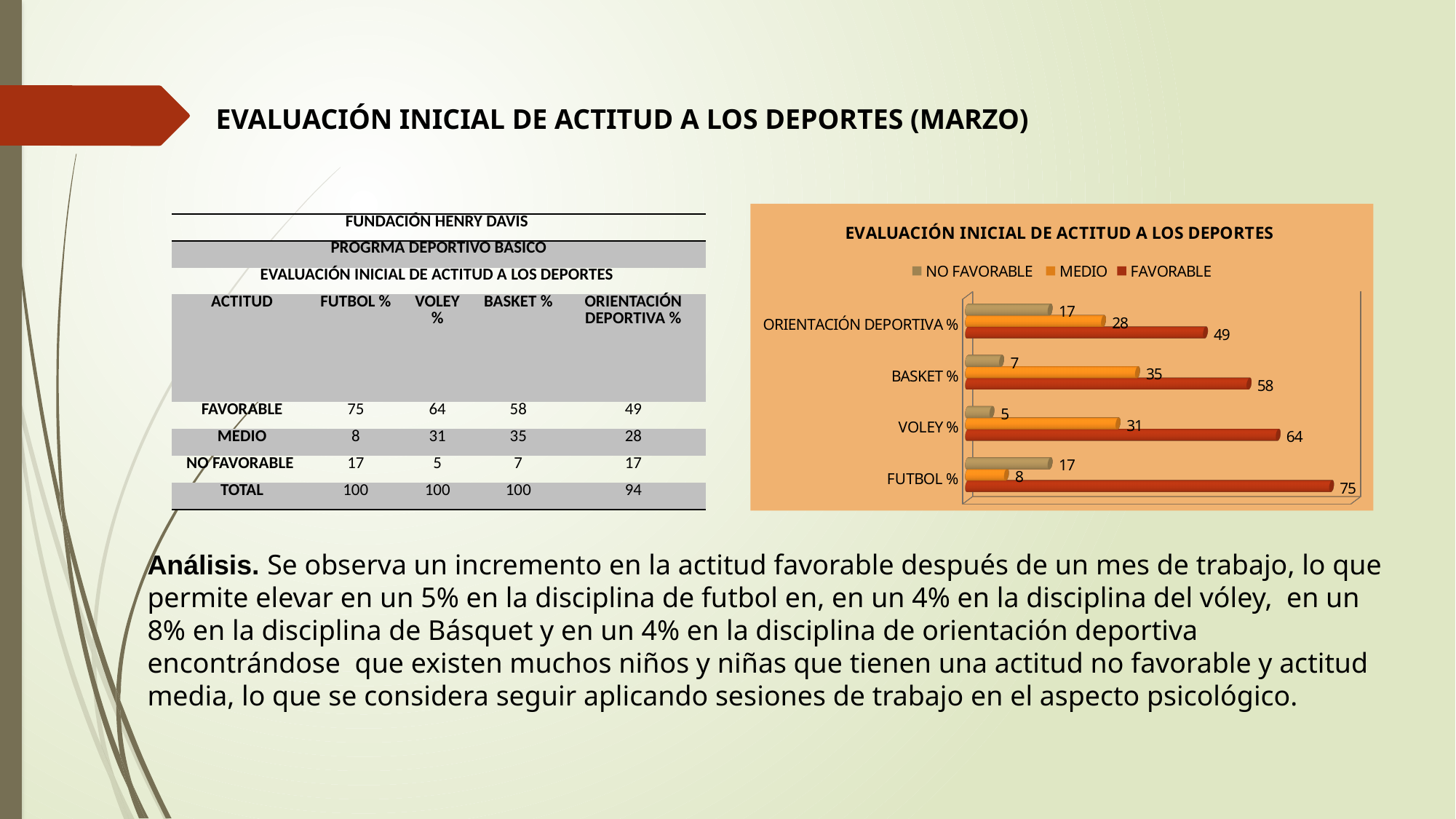
How many series does the chart legend list? 3 How many categories are shown on the chart's vertical axis? 4 What kind of chart is shown on the slide? Bar chart Which is larger, the MEDIO value for VOLEY % or the MEDIO value for ORIENTACIÓN DEPORTIVA %? VOLEY % What is the title of the chart? EVALUACIÓN INICIAL DE ACTITUD A LOS DEPORTES Which category has the highest FAVORABLE value? FUTBOL % Which category has the lowest NO FAVORABLE value? VOLEY % What is the NO FAVORABLE value for VOLEY % in the chart? 5 Which series is shown in dark red in the chart? FAVORABLE What is the difference between the FAVORABLE values for FUTBOL % and ORIENTACIÓN DEPORTIVA %? 26 What is the FAVORABLE value for FUTBOL % in the chart? 75 What is the MEDIO value for BASKET % in the chart? 35